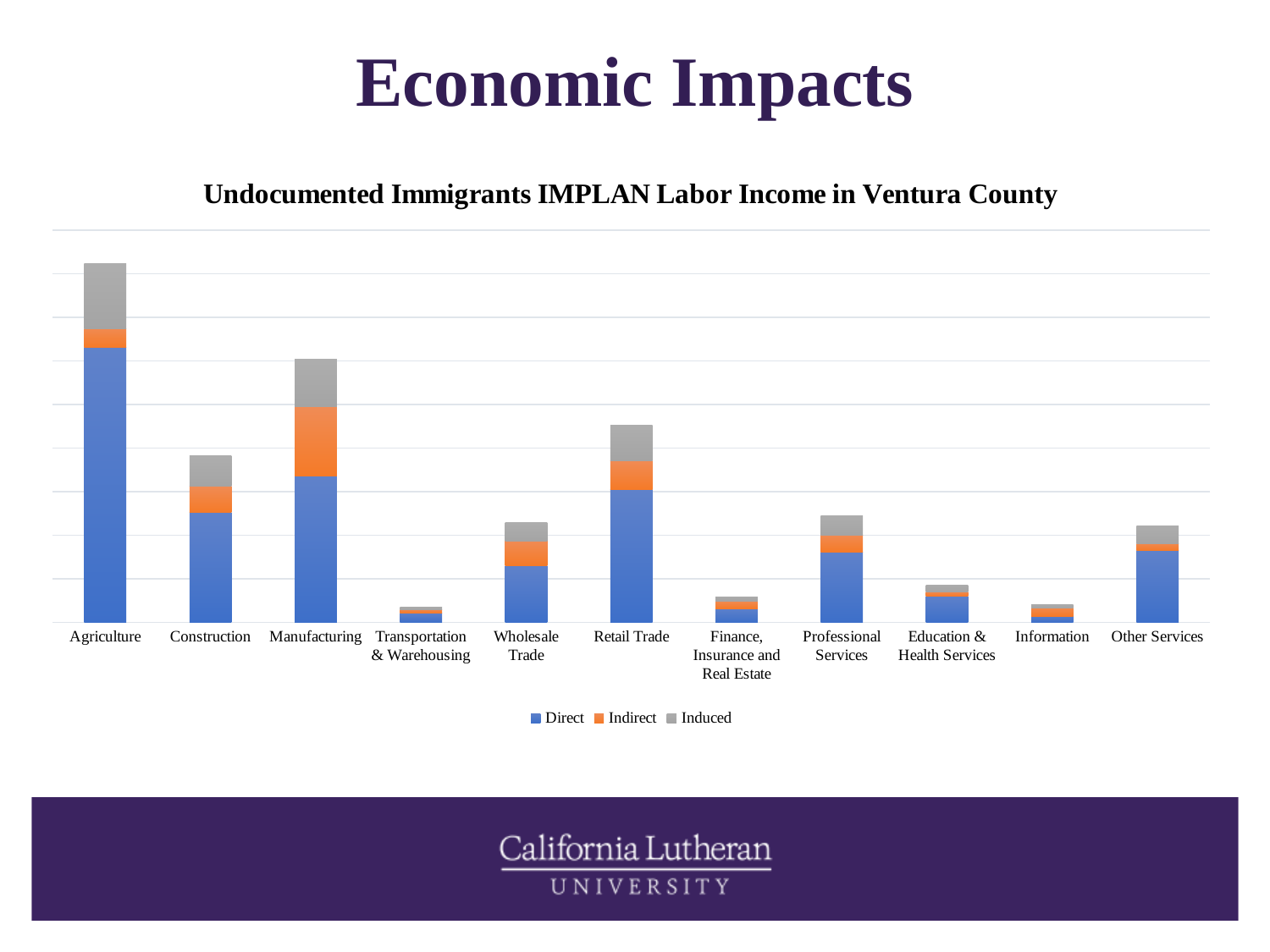
Which has the taller total bar, Manufacturing or Construction? Manufacturing Which has the taller total bar, Retail Trade or Wholesale Trade? Retail Trade Which industry has the largest Indirect (orange) segment? Manufacturing Which has the taller total bar, Professional Services or Education & Health Services? Professional Services Which industry has the highest total labor income bar? Agriculture Which industry has the largest Direct (blue) segment? Agriculture What are the three series named in the legend? Direct, Indirect, Induced How many series does the legend list? 3 How many industry categories are shown on the x axis? 11 What kind of chart is shown on the slide? Stacked bar chart What is the title of the chart? Undocumented Immigrants IMPLAN Labor Income in Ventura County